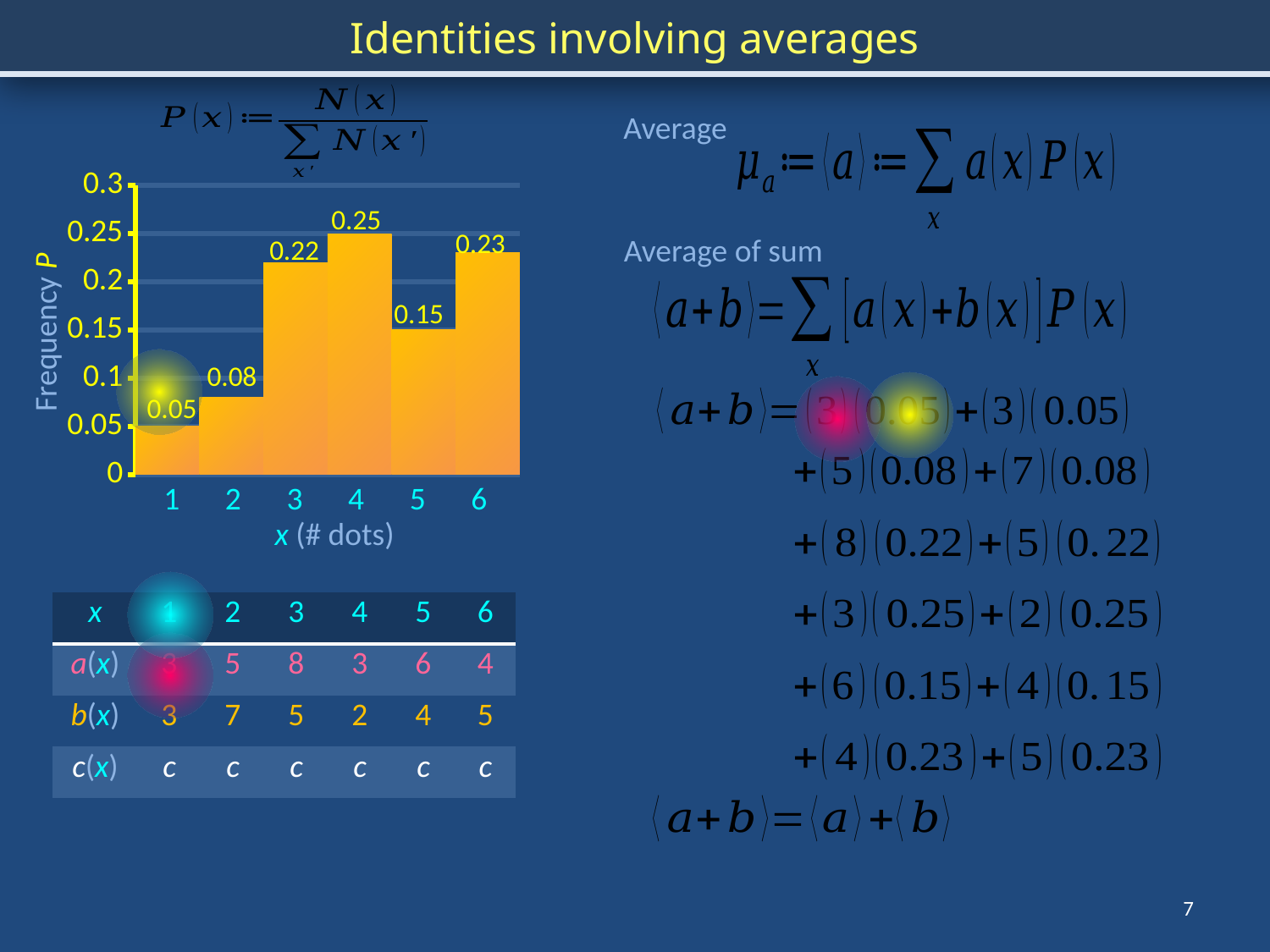
Which value of x has the highest frequency P? 4 What is the frequency P for x = 4? 0.25 What is the frequency P for x = 6? 0.23 What kind of chart is shown on the slide? bar chart What is the label of the horizontal axis of the chart? x (# dots) What is the frequency P for x = 1? 0.05 Is the frequency P for x = 2 greater or less than 0.1? less What is the difference between the frequency at x = 4 and the frequency at x = 5? 0.10 Which has a larger frequency P, x = 3 or x = 6? x = 6 Which value of x has the lowest frequency P? 1 How many values of x are plotted in the chart? 6 What is the label of the vertical axis of the chart? Frequency P